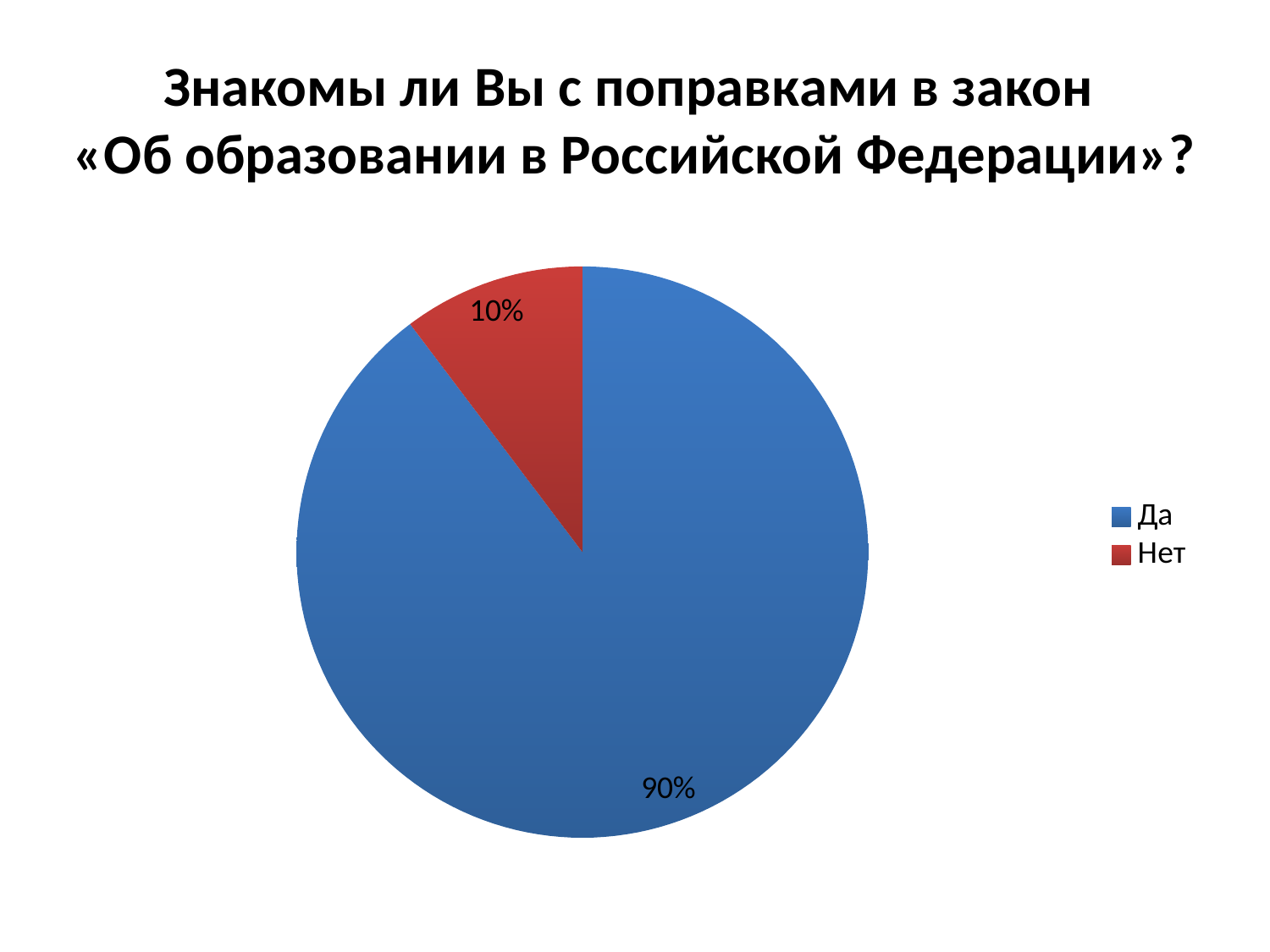
What share of the pie is labelled "Да"? 90% Which category has the largest slice of the pie? Да Which slice is larger, "Да" or "Нет"? Да What colour is the "Да" slice? Blue How many slices does the pie chart have? 2 What kind of chart is shown on the slide? Pie chart What colour is the "Нет" slice? Red What share of the pie is labelled "Нет"? 10% How many entries does the legend list? 2 What is the difference in percentage points between the "Да" and "Нет" slices? 80 Which category has the smallest slice of the pie? Нет